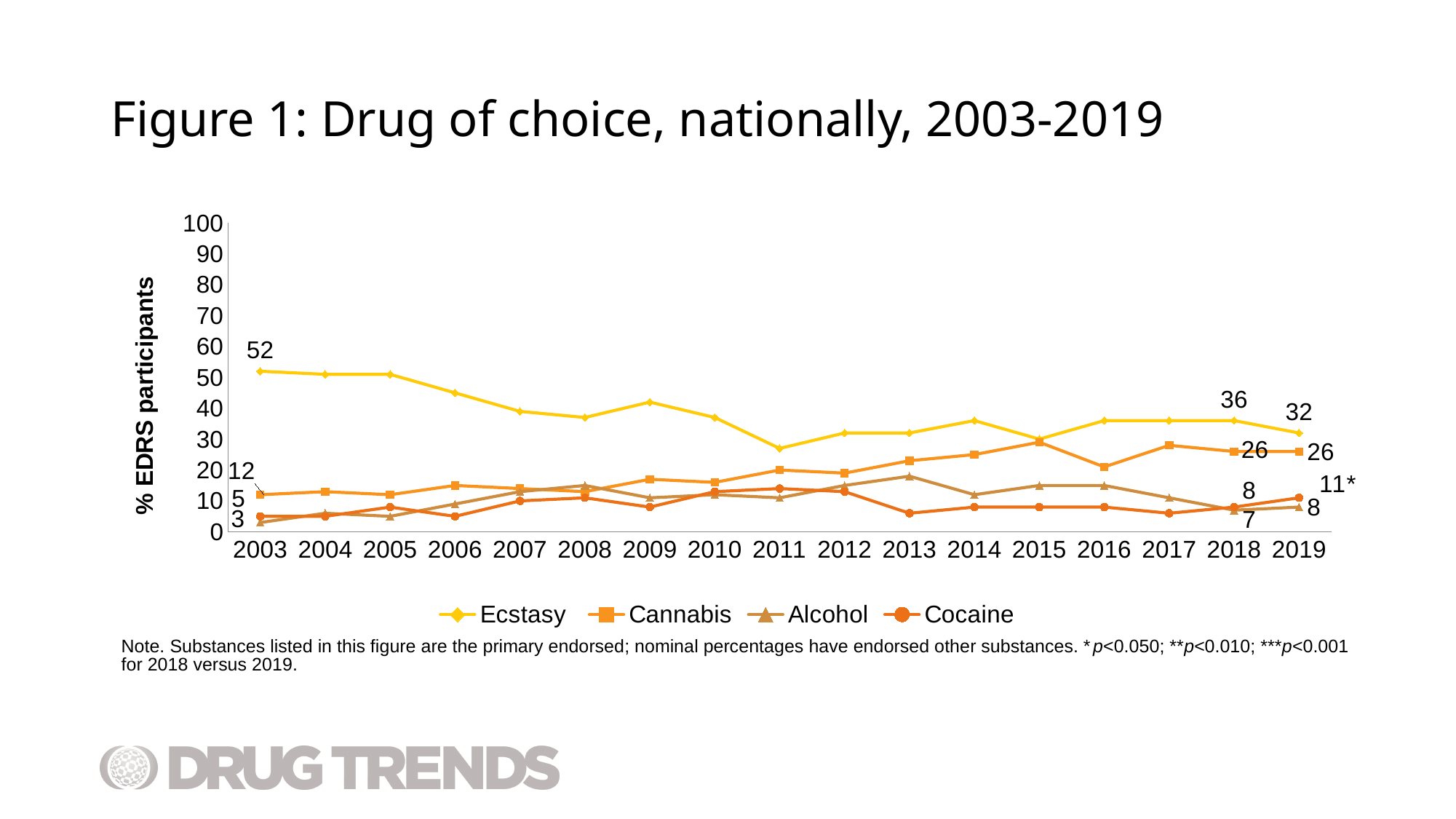
By how much did the Ecstasy value fall from 2003 to 2019? 20 What is the value for Cannabis in 2019? 26 What is the label on the y axis? % EDRS participants What is the value for Ecstasy in 2003? 52 Does the Ecstasy line generally rise or fall from 2003 to 2019? fall How many series does the legend list? 4 What is the value for Cocaine in 2019? 11* Which series has the highest value in 2019? Ecstasy How many years are plotted along the x axis? 17 What is the value for Ecstasy in 2019? 32 What kind of chart is shown on the slide? line chart Is the value for Ecstasy in 2006 greater or less than 40? greater